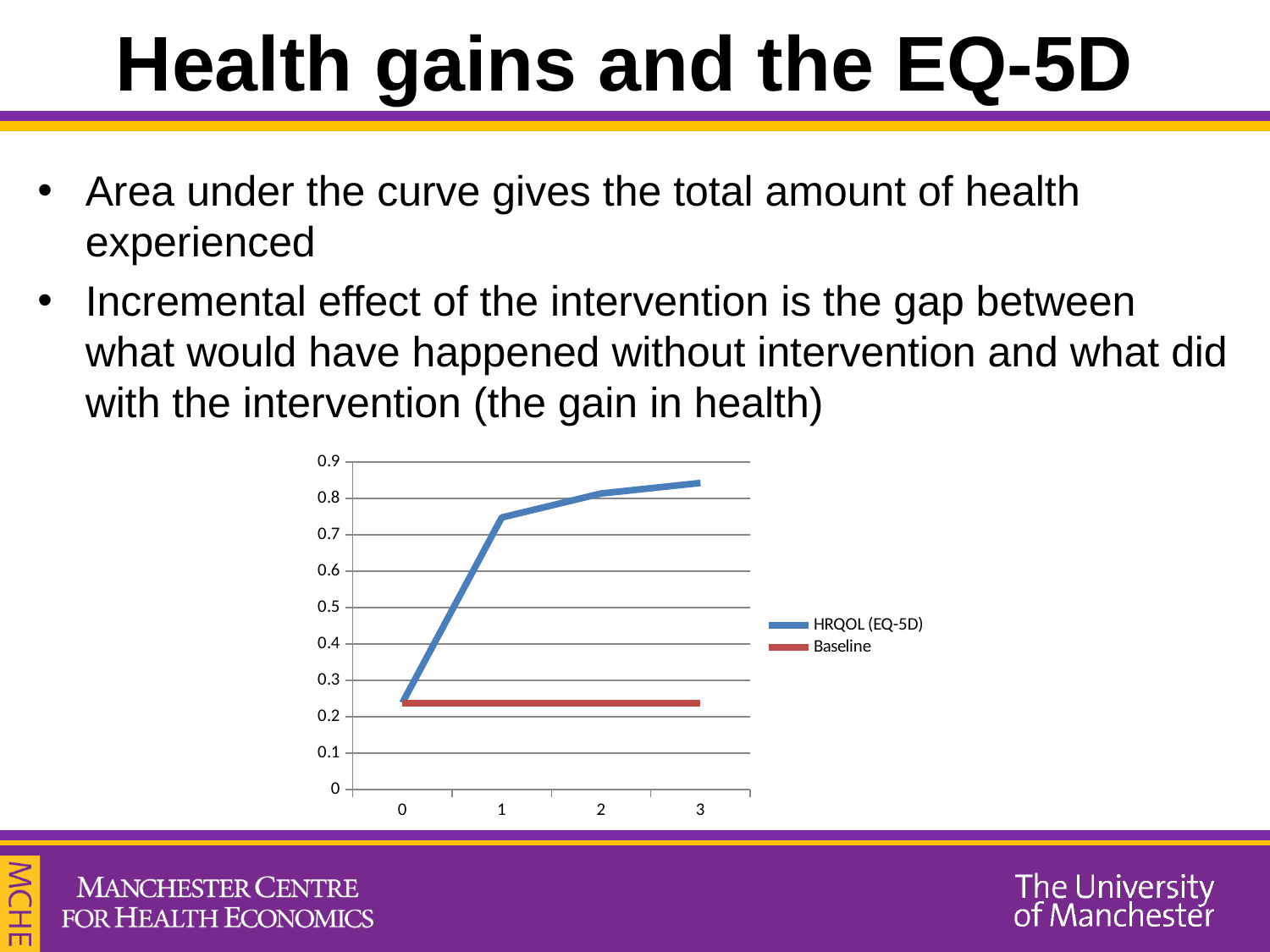
What colour is the Baseline line in the chart? red What are the two series named in the legend? HRQOL (EQ-5D) and Baseline How many points are plotted along the x axis for each series? 4 Is the value of HRQOL (EQ-5D) at x = 0 greater or less than 0.4? less What kind of chart is shown on the slide? line chart Is the Baseline value at x = 2 greater or less than 0.3? less Does the HRQOL (EQ-5D) series rise or fall from x = 0 to x = 3? rise Is the value of HRQOL (EQ-5D) at x = 3 greater or less than 0.8? greater How many series does the chart's legend list? 2 At x = 2, which series has the larger value, HRQOL (EQ-5D) or Baseline? HRQOL (EQ-5D) Does the Baseline series rise, fall or stay flat across the x axis? stay flat